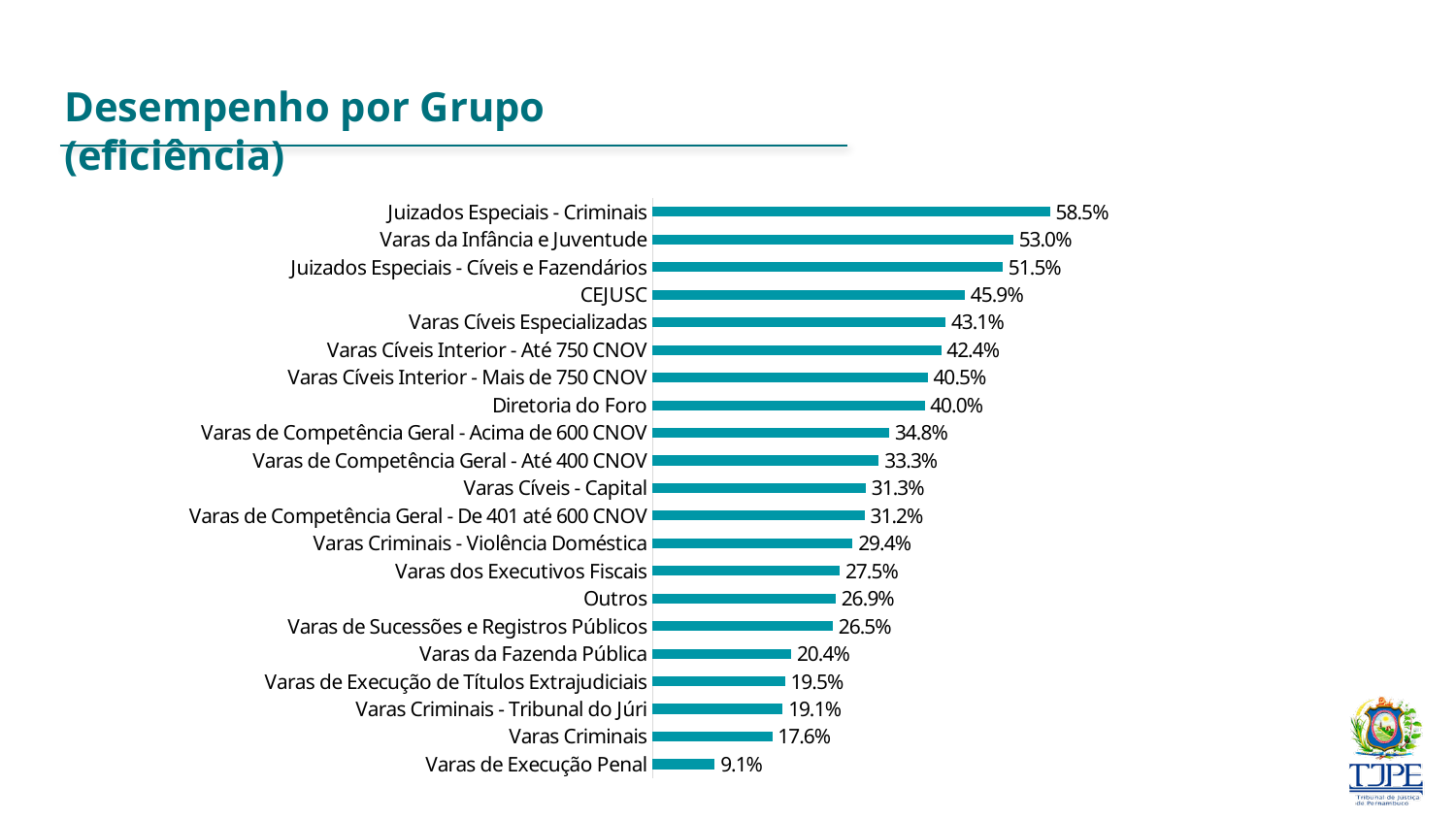
Which is larger, the value for Varas Cíveis Especializadas or the value for Varas dos Executivos Fiscais? Varas Cíveis Especializadas What is the title of the slide? Desempenho por Grupo (eficiência) What is the difference between the values for Varas da Infância e Juventude and CEJUSC? 7.1% What kind of chart is shown on the slide? Bar chart Which category has the lowest value? Varas de Execução Penal What is the value for Outros? 26.9% What is the value for Varas da Fazenda Pública? 20.4% Which category has the highest value? Juizados Especiais - Criminais What is the value for CEJUSC? 45.9% What is the value for Diretoria do Foro? 40.0% What is the difference between the values for Juizados Especiais - Criminais and Varas de Execução Penal? 49.4% How many categories are shown in the chart? 21